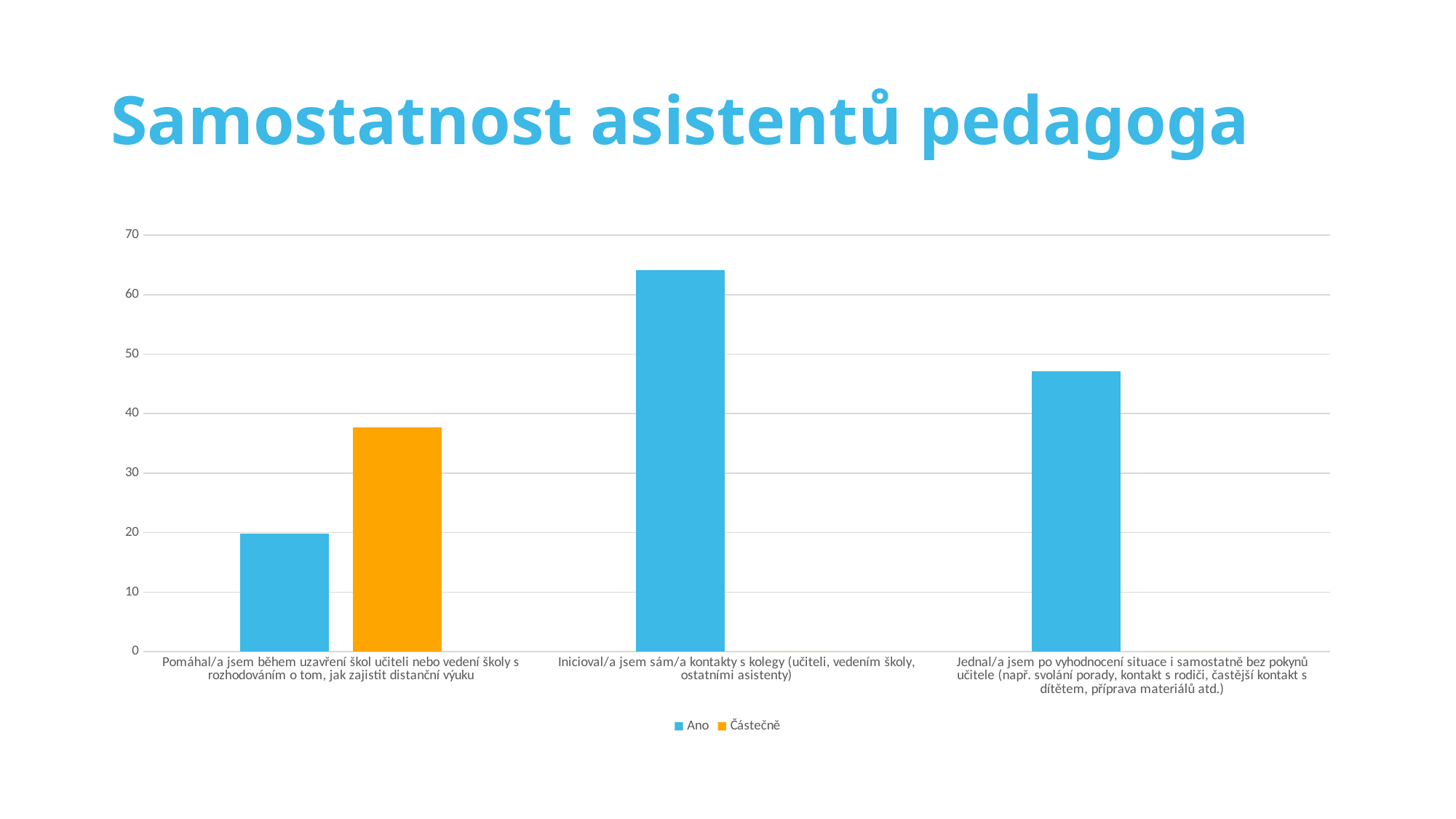
How many categories are shown on the x axis? 3 Which category has the highest Ano value? Inicioval/a jsem sám/a kontakty s kolegy (učiteli, vedením školy, ostatními asistenty) How many series does the legend list? 2 Is the Ano value for 'Pomáhal/a jsem během uzavření škol učiteli nebo vedení školy' greater or less than 30? less What is the title of the slide? Samostatnost asistentů pedagoga Is the Částečně value for 'Pomáhal/a jsem během uzavření škol učiteli nebo vedení školy' greater or less than 40? less Is the Ano value for 'Inicioval/a jsem sám/a kontakty s kolegy' greater or less than 60? greater Which category has the lowest Ano value? Pomáhal/a jsem během uzavření škol učiteli nebo vedení školy s rozhodováním o tom, jak zajistit distanční výuku For the category 'Pomáhal/a jsem během uzavření škol učiteli nebo vedení školy', which is larger: the Ano value or the Částečně value? Částečně What kind of chart is shown on the slide? bar chart What are the two series named in the legend? Ano, Částečně